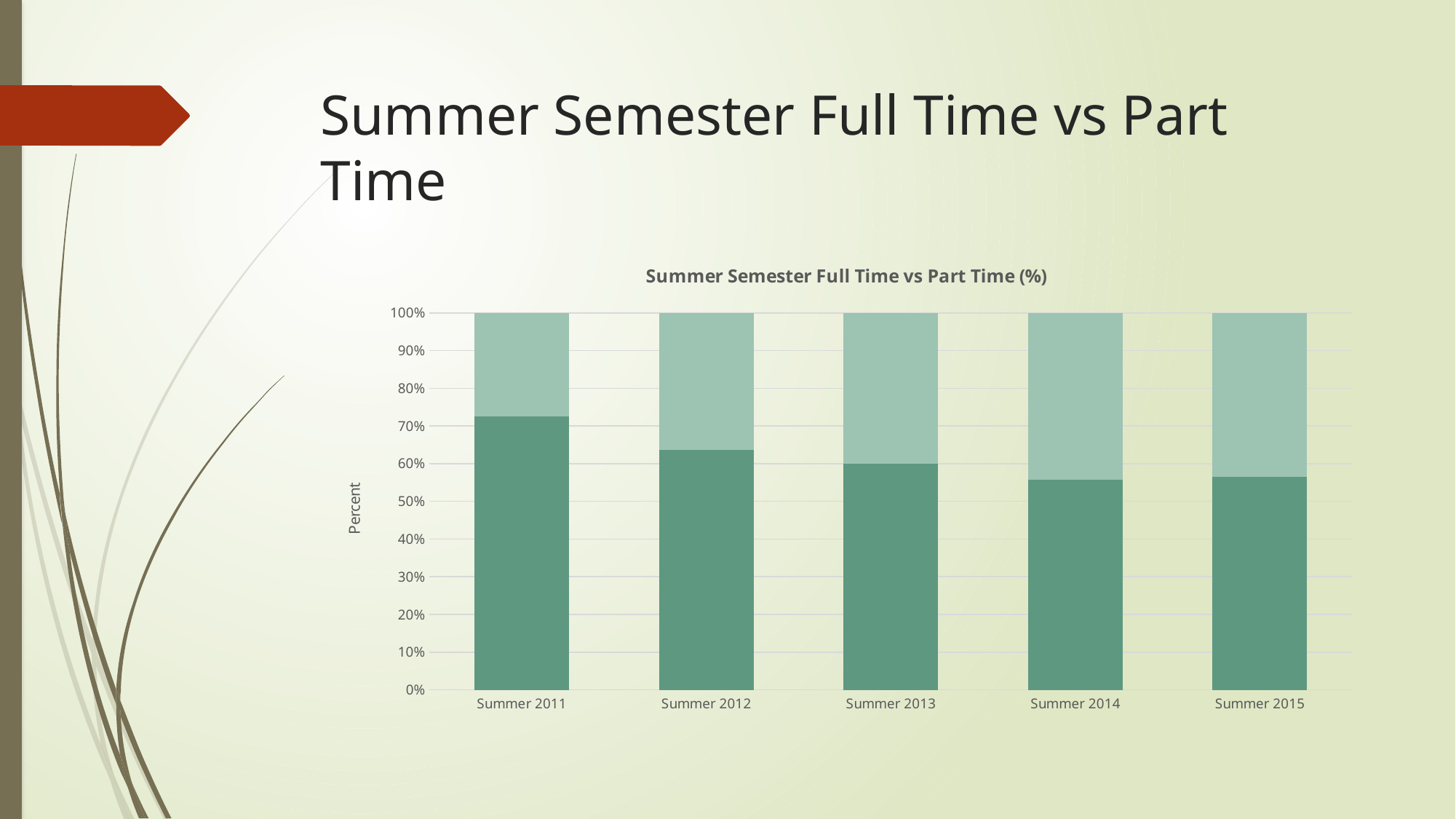
Which has the larger darker (bottom) segment, Summer 2011 or Summer 2013? Summer 2011 Is the darker (bottom) segment for Summer 2011 greater or less than 70%? greater What is the total height of the stacked bar for Summer 2013? 100% What is the label on the vertical axis of the chart? Percent How many summer semesters are shown on the x axis of the chart? 5 What kind of chart is shown on the slide? Stacked bar chart Which summer semester has the largest darker (bottom) segment? Summer 2011 What is the title of the chart? Summer Semester Full Time vs Part Time (%) Is the darker (bottom) segment for Summer 2012 greater or less than 60%? greater Does the darker (bottom) segment rise or fall from Summer 2011 to Summer 2014? Fall Is the darker (bottom) segment for Summer 2015 greater or less than 50%? greater